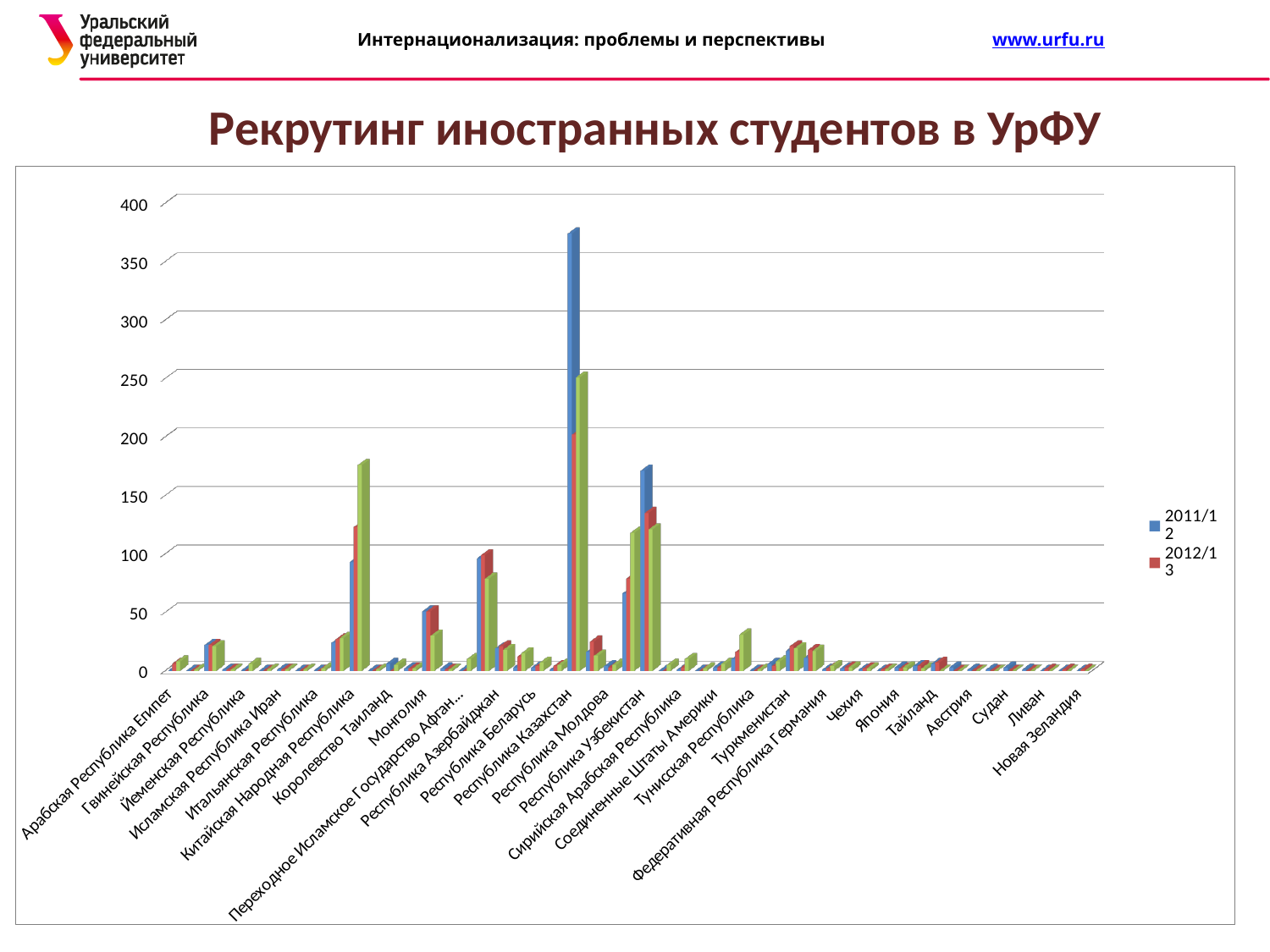
For Китайская Народная Республика, which is larger: the 2011/12 value or the 2012/13 value? 2012/13 Is the 2012/13 value for Китайская Народная Республика greater or less than 100? greater Is the 2011/12 value for Республика Казахстан greater or less than 350? greater Which is larger for the 2011/12 series: Республика Казахстан or Республика Узбекистан? Республика Казахстан What kind of chart is shown on the slide? bar chart For Республика Казахстан, which is larger: the 2011/12 value or the 2012/13 value? 2011/12 What is the title of the chart on the slide? Рекрутинг иностранных студентов в УрФУ Is the 2011/12 value for Республика Узбекистан greater or less than 150? greater Which series are listed in the chart legend? 2011/12 and 2012/13 Which country has the highest value for the 2011/12 series? Республика Казахстан